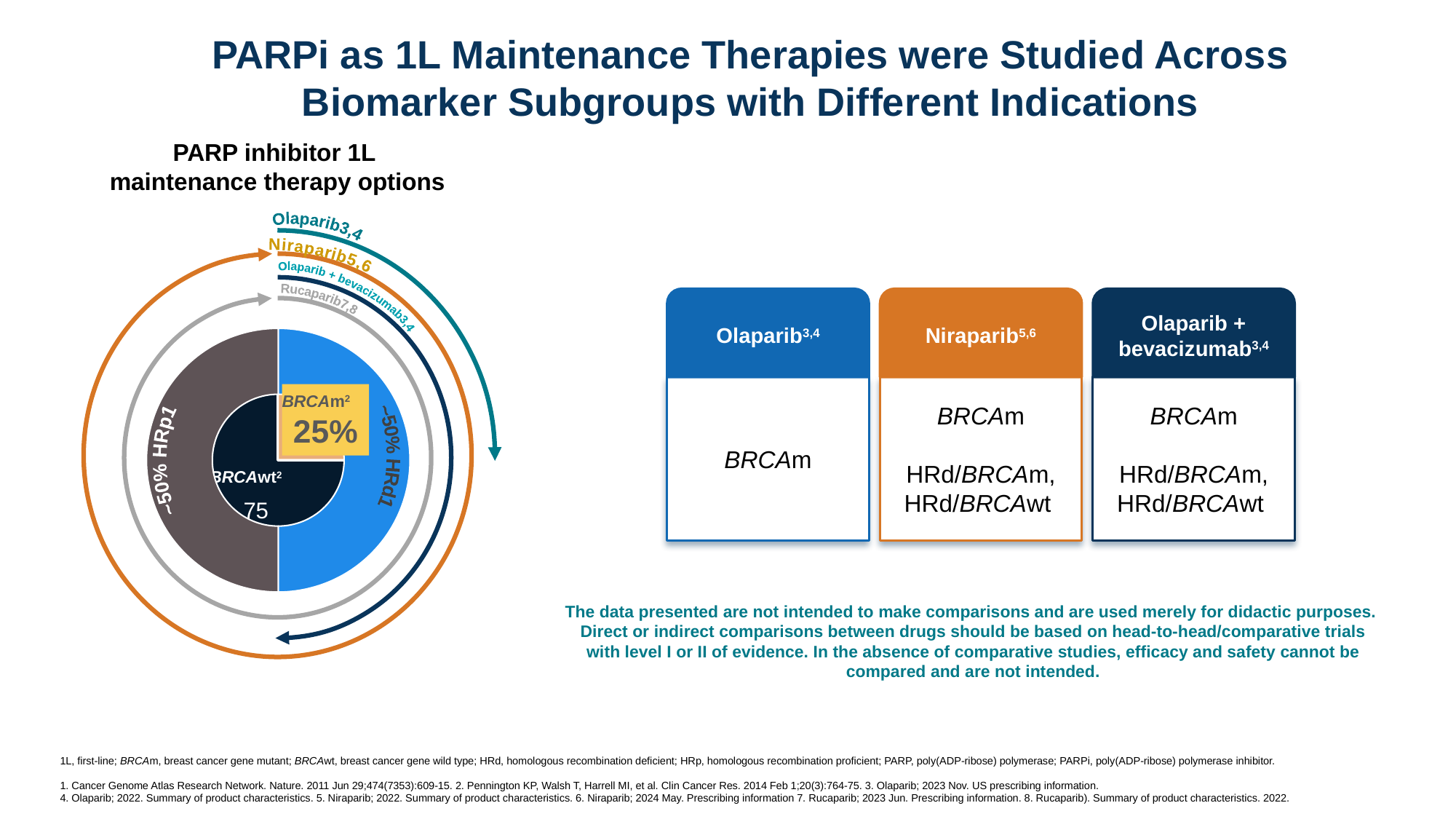
How many PARP inhibitor therapy options are labelled on the arcs around the pie chart? 4 What colour is the BRCAm 25% segment in the pie chart? yellow What kind of chart is shown on the left of the slide? pie chart What value is shown for the BRCAwt segment of the pie chart? 75 What is the title of the chart on the left of the slide? PARP inhibitor 1L maintenance therapy options What is the difference between the BRCAwt value (75) and the BRCAm value (25) in the pie chart? 50 Is the BRCAm share in the pie chart greater or less than 50%? less Which segment is larger in the pie chart, BRCAm or BRCAwt? BRCAwt What percentage of the pie chart is labelled BRCAm? 25%